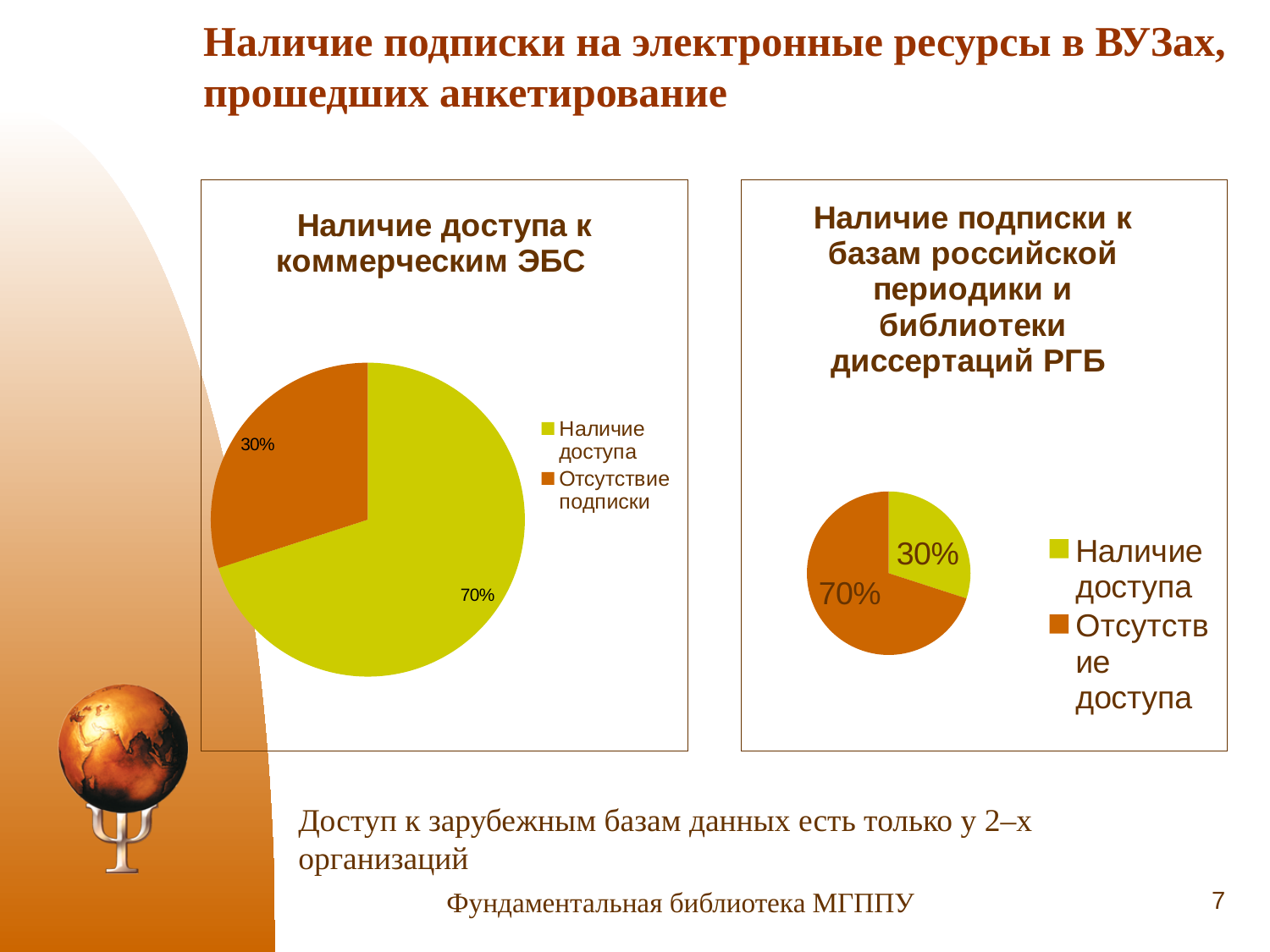
In the right chart, "Наличие подписки к базам российской периодики и библиотеки диссертаций РГБ", which slice is the smallest? Наличие доступа In the left chart, "Наличие доступа к коммерческим ЭБС", what share is "Отсутствие подписки"? 30% In the left chart, "Наличие доступа к коммерческим ЭБС", what colour is the "Наличие доступа" slice? Yellow-green What kind of chart is the left chart, "Наличие доступа к коммерческим ЭБС"? Pie chart How many entries does the legend of the right chart, "Наличие подписки к базам российской периодики и библиотеки диссертаций РГБ", list? 2 In the left chart, "Наличие доступа к коммерческим ЭБС", how many slices does the pie have? 2 In the left chart, "Наличие доступа к коммерческим ЭБС", what share is "Наличие доступа"? 70% In the right chart, "Наличие подписки к базам российской периодики и библиотеки диссертаций РГБ", what share is "Отсутствие доступа"? 70% In the right chart, "Наличие подписки к базам российской периодики и библиотеки диссертаций РГБ", which is larger: "Наличие доступа" or "Отсутствие доступа"? Отсутствие доступа In the left chart, "Наличие доступа к коммерческим ЭБС", which slice is the largest? Наличие доступа In the left chart, "Наличие доступа к коммерческим ЭБС", what is the difference between the "Наличие доступа" and "Отсутствие подписки" shares? 40%